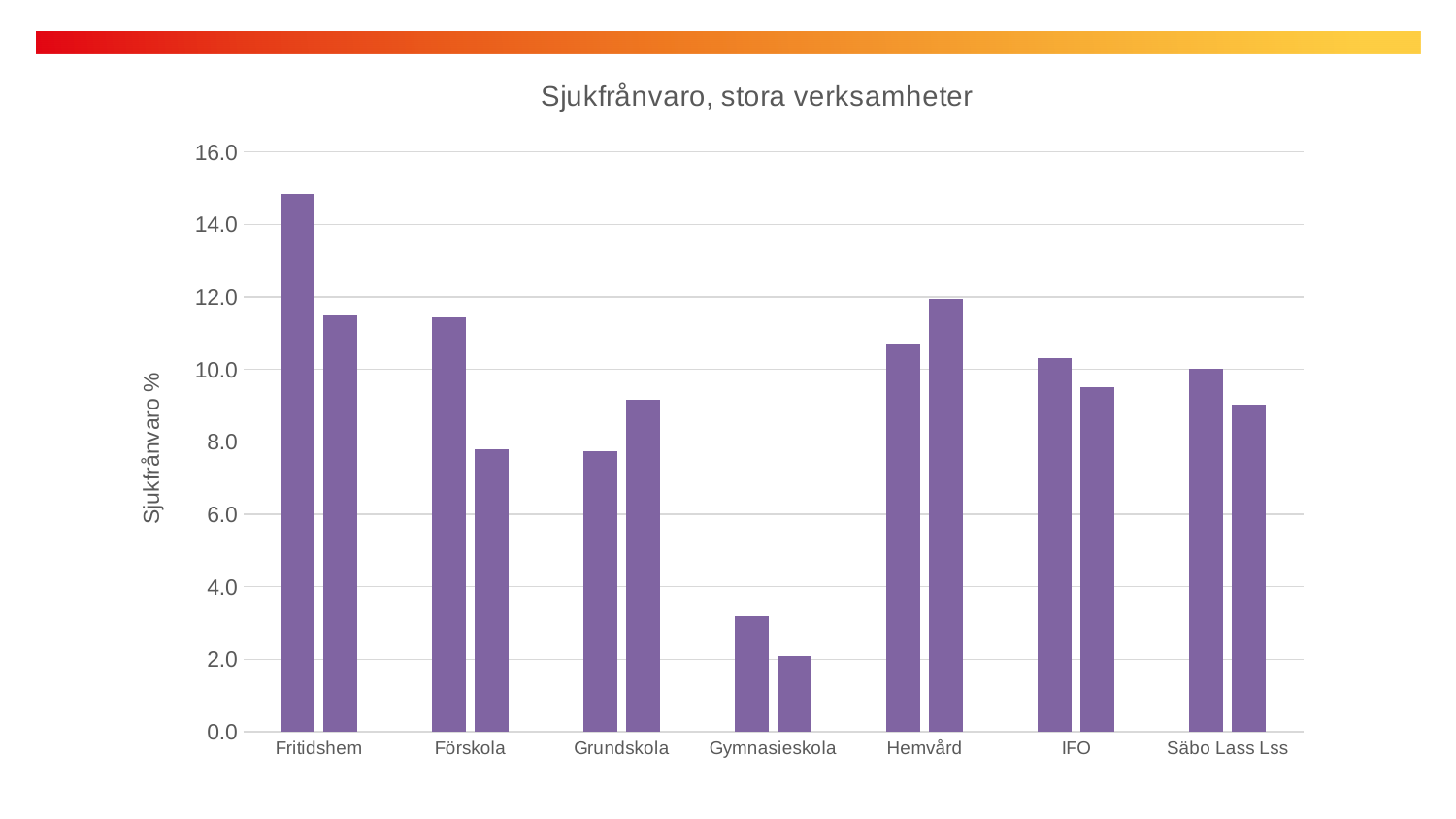
What is the title of the chart? Sjukfrånvaro, stora verksamheter Which category has the shortest bar in the chart? Gymnasieskola Which is larger, the left bar for Fritidshem or the left bar for Förskola? Fritidshem How many categories are shown on the x axis of the chart? 7 Which category has the tallest bar in the chart? Fritidshem Is the value of the left bar for Gymnasieskola greater or less than 4.0? less Is the value of the left bar for Hemvård greater or less than 10.0? greater What kind of chart is shown on the slide? bar chart What is the label of the vertical axis? Sjukfrånvaro % Is the value of the left bar for Fritidshem greater or less than 14.0? greater